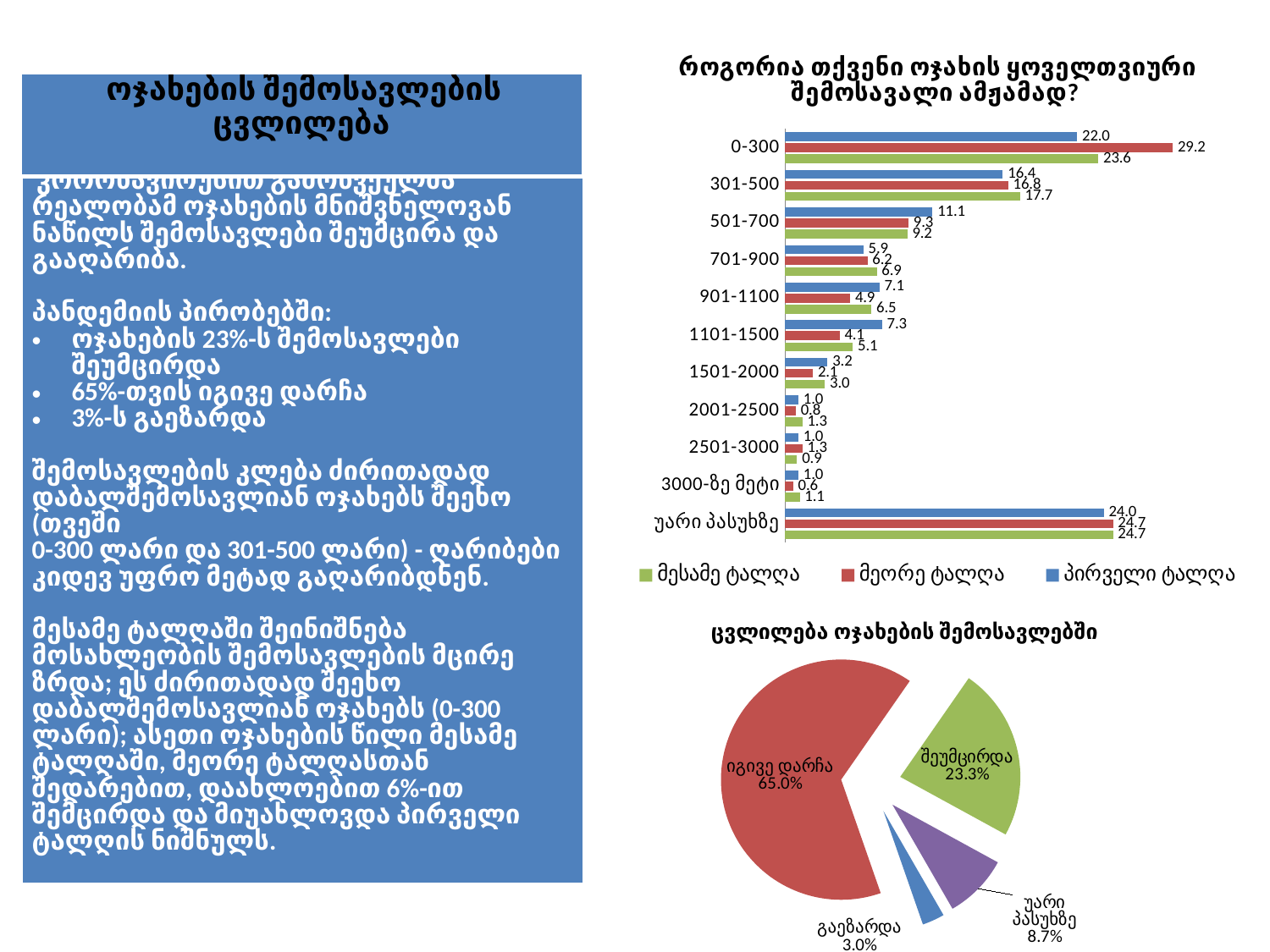
How many income categories are shown in the bar chart titled "როგორია თქვენი ოჯახის ყოველთვიური შემოსავალი ამჟამად?"? 11 In the bar chart titled "როგორია თქვენი ოჯახის ყოველთვიური შემოსავალი ამჟამად?", which category has the highest value in the მეორე ტალღა series? 0-300 In the bar chart titled "როგორია თქვენი ოჯახის ყოველთვიური შემოსავალი ამჟამად?", what is the difference between the მეორე ტალღა and მესამე ტალღა values for the 0-300 category? 5.6 In the pie chart titled "ცვლილება ოჯახების შემოსავლებში", what share does the იგივე დარჩა slice have? 65.0% In the bar chart titled "როგორია თქვენი ოჯახის ყოველთვიური შემოსავალი ამჟამად?", what is the value for the 0-300 category in the მეორე ტალღა series? 29.2 In the bar chart titled "როგორია თქვენი ოჯახის ყოველთვიური შემოსავალი ამჟამად?", which category has the lowest value in the მეორე ტალღა series? 3000-ზე მეტი In the bar chart titled "როგორია თქვენი ოჯახის ყოველთვიური შემოსავალი ამჟამად?", which is larger for 1101-1500: the პირველი ტალღა value or the მეორე ტალღა value? პირველი ტალღა In the pie chart titled "ცვლილება ოჯახების შემოსავლებში", which slice is the smallest? გაეზარდა What type of chart is the chart titled "როგორია თქვენი ოჯახის ყოველთვიური შემოსავალი ამჟამად?"? bar chart How many series does the legend of the bar chart titled "როგორია თქვენი ოჯახის ყოველთვიური შემოსავალი ამჟამად?" list? 3 In the bar chart titled "როგორია თქვენი ოჯახის ყოველთვიური შემოსავალი ამჟამად?", what is the value for 501-700 in the პირველი ტალღა series? 11.1 How many slices does the pie chart titled "ცვლილება ოჯახების შემოსავლებში" have? 4